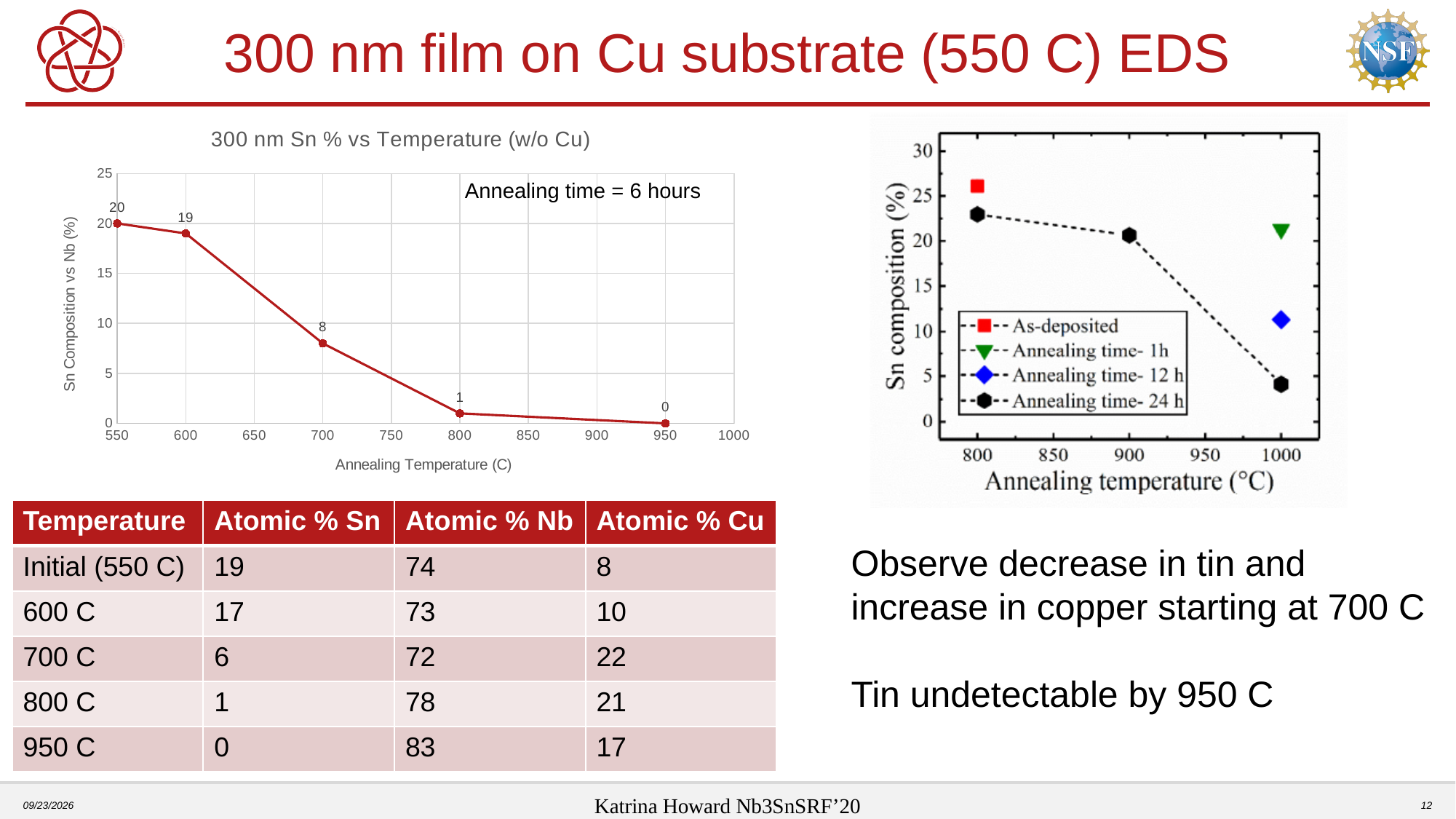
In the chart titled "300 nm Sn % vs Temperature (w/o Cu)", at which annealing temperature is the Sn composition highest? 550 In the chart titled "300 nm Sn % vs Temperature (w/o Cu)", how many data points are plotted? 5 In the chart titled "300 nm Sn % vs Temperature (w/o Cu)", is the Sn composition higher at 700 C or at 800 C? 700 C In the chart on the right of the slide, how many series does the legend list? 4 In the chart titled "300 nm Sn % vs Temperature (w/o Cu)", at which annealing temperature is the Sn composition lowest? 950 In the chart titled "300 nm Sn % vs Temperature (w/o Cu)", what is the Sn composition at 700 C? 8 In the chart titled "300 nm Sn % vs Temperature (w/o Cu)", what is the difference between the Sn composition at 600 C and at 700 C? 11 In the chart titled "300 nm Sn % vs Temperature (w/o Cu)", what is the Sn composition at an annealing temperature of 550 C? 20 In the chart titled "300 nm Sn % vs Temperature (w/o Cu)", does the Sn composition rise or fall as annealing temperature increases? Fall What kind of chart is the one titled "300 nm Sn % vs Temperature (w/o Cu)"? Line chart In the chart titled "300 nm Sn % vs Temperature (w/o Cu)", what is the Sn composition at 950 C? 0 In the chart on the right of the slide, is the Sn composition for the 24 h annealing time at 1000 °C greater or less than 10? less